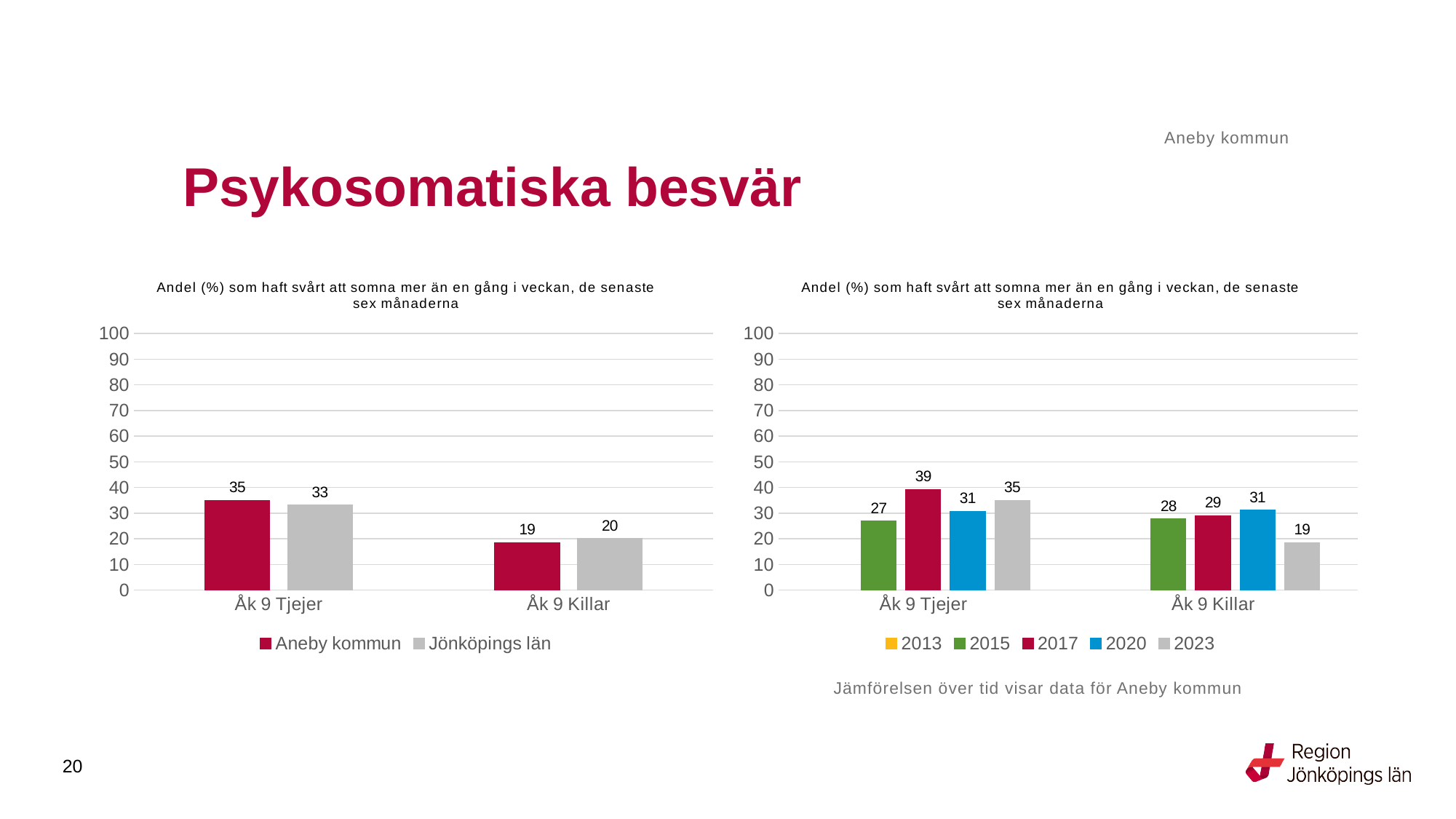
In the right chart, what is the difference between the 2017 and 2015 values for Åk 9 Tjejer? 12 In the left chart, what is the value for Jönköpings län for Åk 9 Killar? 20 In the right chart, which year has the lowest value for Åk 9 Killar? 2023 How many series does the legend of the right chart list? 5 How many series does the legend of the left chart list? 2 In the right chart, what is the value for 2023 for Åk 9 Killar? 19 In the left chart, which is larger for Åk 9 Killar: Aneby kommun or Jönköpings län? Jönköpings län In the right chart, which year has the highest value for Åk 9 Tjejer? 2017 What kind of chart is the right chart? Bar chart In the left chart, what is the difference between Aneby kommun and Jönköpings län for Åk 9 Tjejer? 2 In the right chart, what is the value for 2017 for Åk 9 Tjejer? 39 In the left chart, what is the value for Aneby kommun for Åk 9 Tjejer? 35